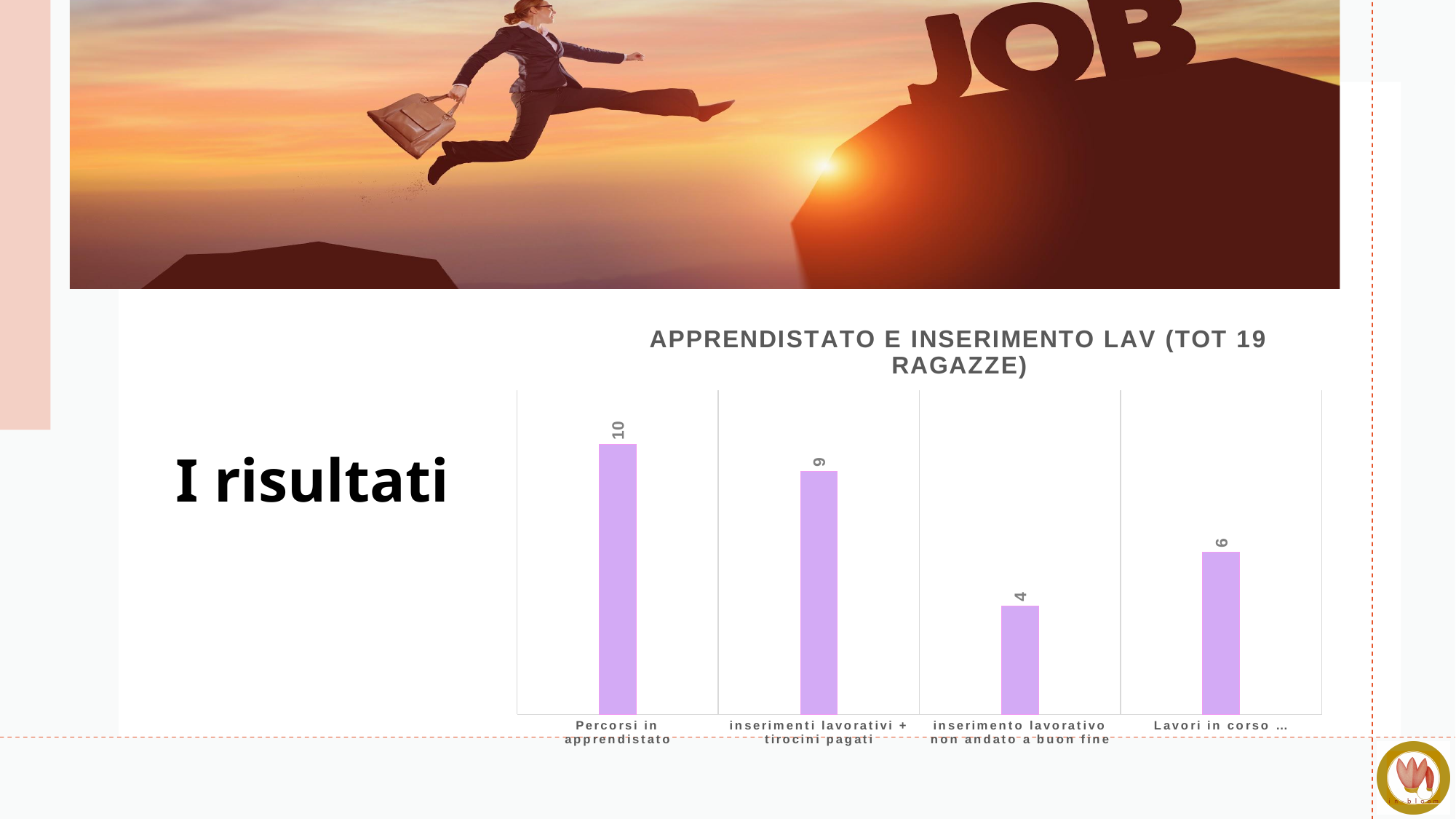
What is the difference between the values for "inserimenti lavorativi + tirocini pagati" and "inserimento lavorativo non andato a buon fine"? 5 What kind of chart is shown on the slide? Bar chart Which category has the highest value? Percorsi in apprendistato What is the value for "Percorsi in apprendistato"? 10 What is the value for "inserimento lavorativo non andato a buon fine"? 4 Which is larger: the value for "inserimenti lavorativi + tirocini pagati" or the value for "Lavori in corso …"? inserimenti lavorativi + tirocini pagati What is the difference between the values for "Percorsi in apprendistato" and "Lavori in corso …"? 4 How many categories are shown in the chart? 4 Which category has the lowest value? inserimento lavorativo non andato a buon fine What is the title of the chart? APPRENDISTATO E INSERIMENTO LAV (TOT 19 RAGAZZE) What is the value for "inserimenti lavorativi + tirocini pagati"? 9 What is the value for "Lavori in corso …"? 6